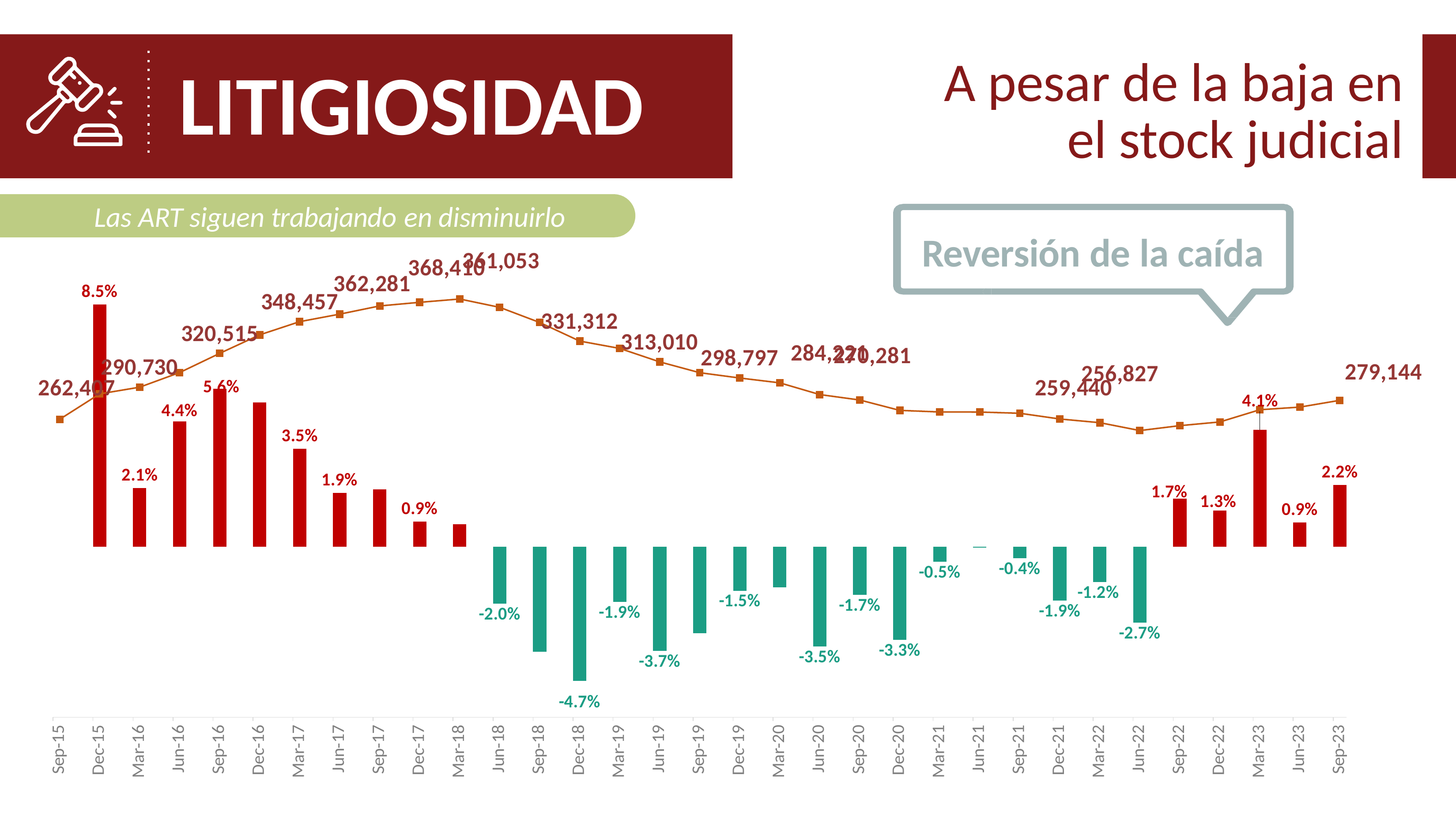
What is the value of the line series at Sep-23, the last point? 279,144 What is the value of the line series at Sep-15, the first point? 262,407 Which bar is larger, Jun-16 or Mar-16? Jun-16 Which period has the lowest bar (most negative percentage change)? Dec-18 What is the percentage change shown for Mar-23? 4.1% What is the percentage change shown for Sep-23? 2.2% What is the highest value labelled on the line series? 368,410 How many quarterly periods are labelled on the x axis of the chart? 33 Which period has the highest bar (percentage change) in the chart? Dec-15 What is the percentage change shown for Dec-15? 8.5% What kind of chart is shown on the slide? A combined bar and line chart What is the percentage change shown for Dec-18? -4.7%